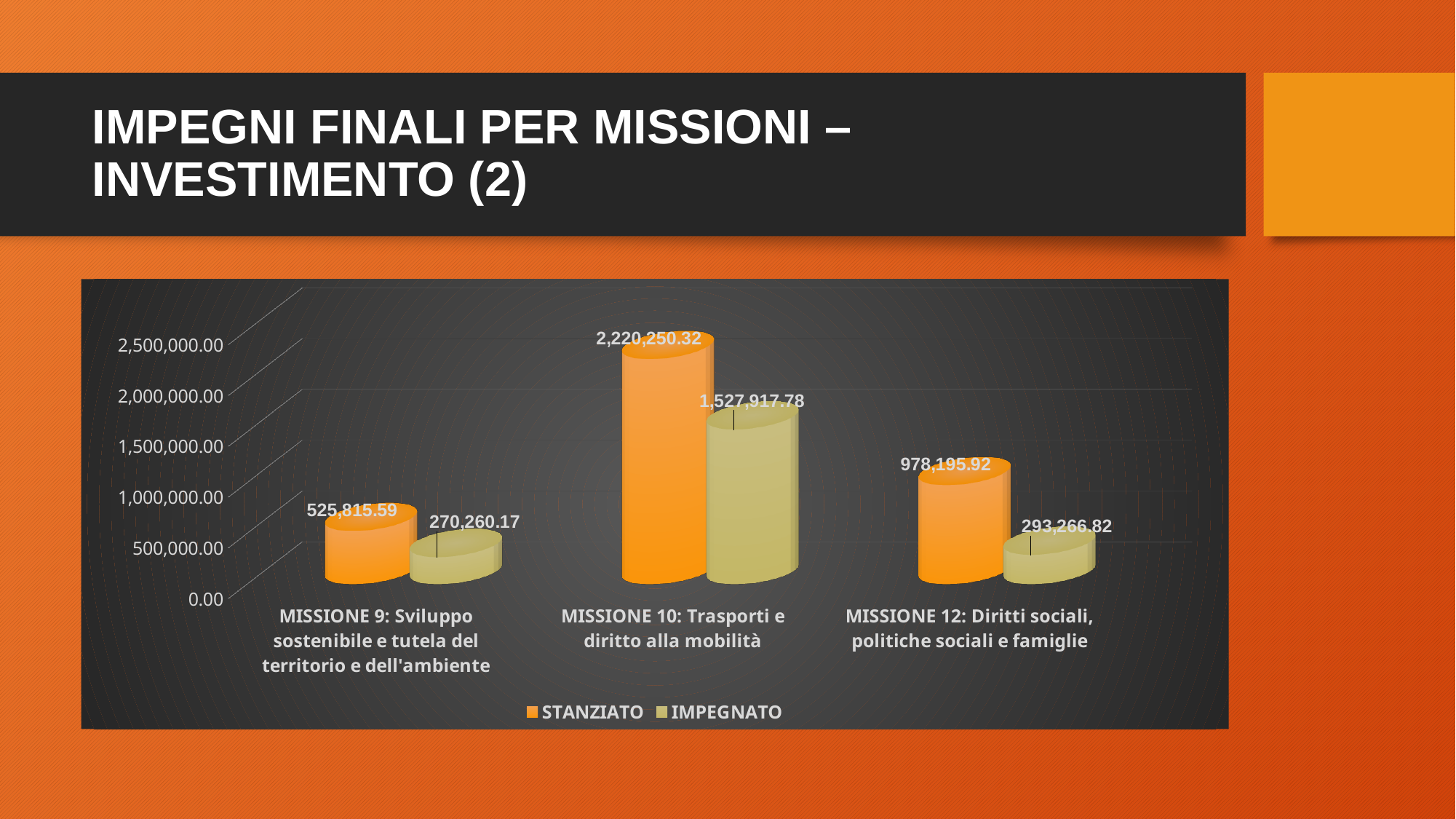
How many series does the legend list? 2 What is the IMPEGNATO value for MISSIONE 12: Diritti sociali, politiche sociali e famiglie? 293,266.82 What is the difference between the STANZIATO and IMPEGNATO values for MISSIONE 10: Trasporti e diritto alla mobilità? 692,332.54 What is the IMPEGNATO value for MISSIONE 9: Sviluppo sostenibile e tutela del territorio e dell'ambiente? 270,260.17 What is the STANZIATO value for MISSIONE 12: Diritti sociali, politiche sociali e famiglie? 978,195.92 Which is larger for MISSIONE 12: the STANZIATO value or the IMPEGNATO value? STANZIATO What is the STANZIATO value for MISSIONE 10: Trasporti e diritto alla mobilità? 2,220,250.32 How many missions (categories) are shown on the x axis? 3 What are the two series named in the legend? STANZIATO and IMPEGNATO Which mission has the highest STANZIATO value? MISSIONE 10: Trasporti e diritto alla mobilità What kind of chart is shown on the slide? Bar chart Which mission has the lowest IMPEGNATO value? MISSIONE 9: Sviluppo sostenibile e tutela del territorio e dell'ambiente